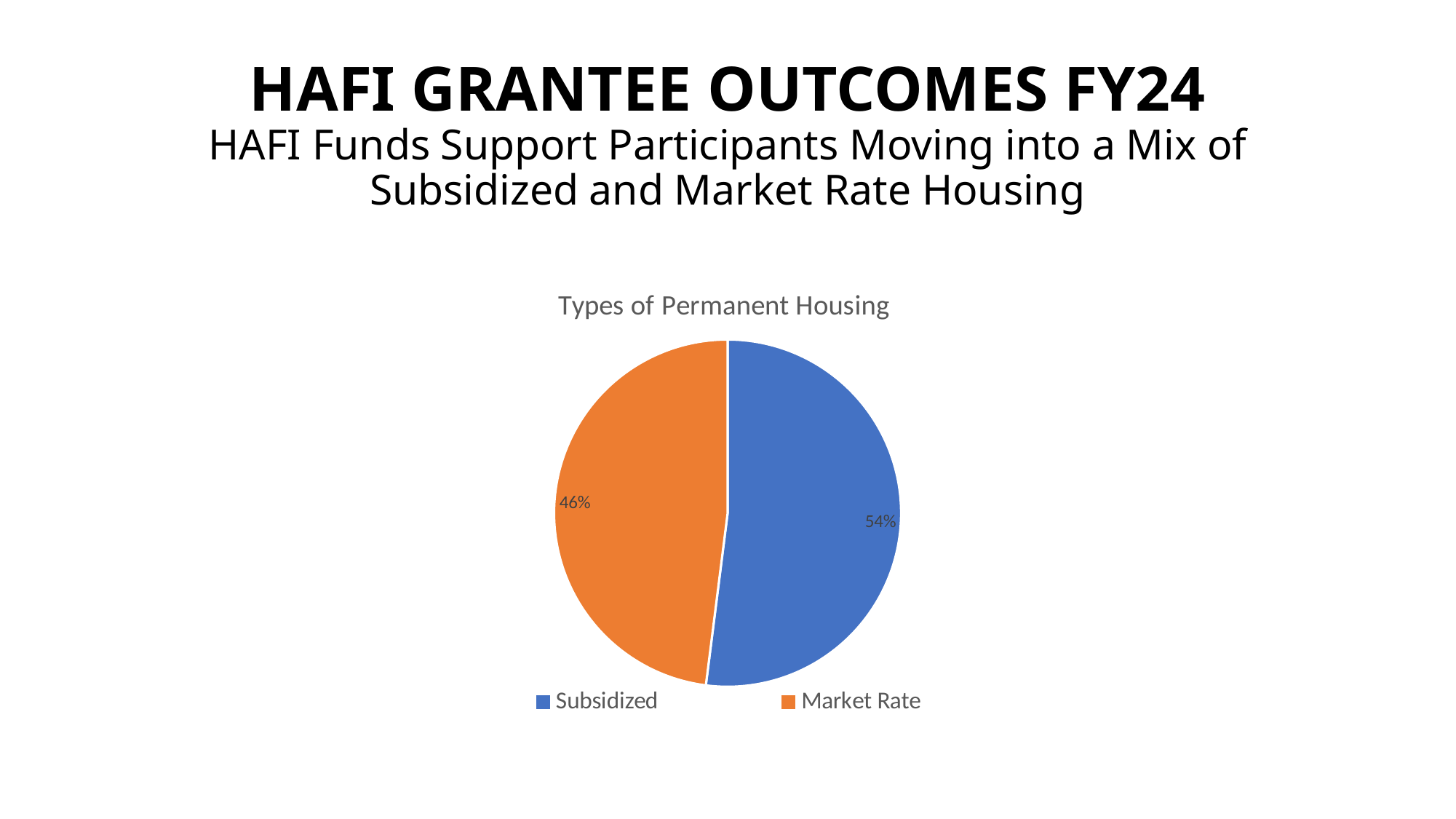
What is the difference in percentage points between the Subsidized and Market Rate slices? 8 Which is larger, the Subsidized slice or the Market Rate slice? Subsidized What is the title of the chart? Types of Permanent Housing Which category has the smallest slice of the pie? Market Rate How many entries does the legend list? 2 What share of the pie is Market Rate? 46% Which category has the largest slice of the pie? Subsidized What share of the pie is Subsidized? 54% How many categories does the pie chart show? 2 What kind of chart is shown on the slide? pie chart What colour is the Market Rate slice? orange